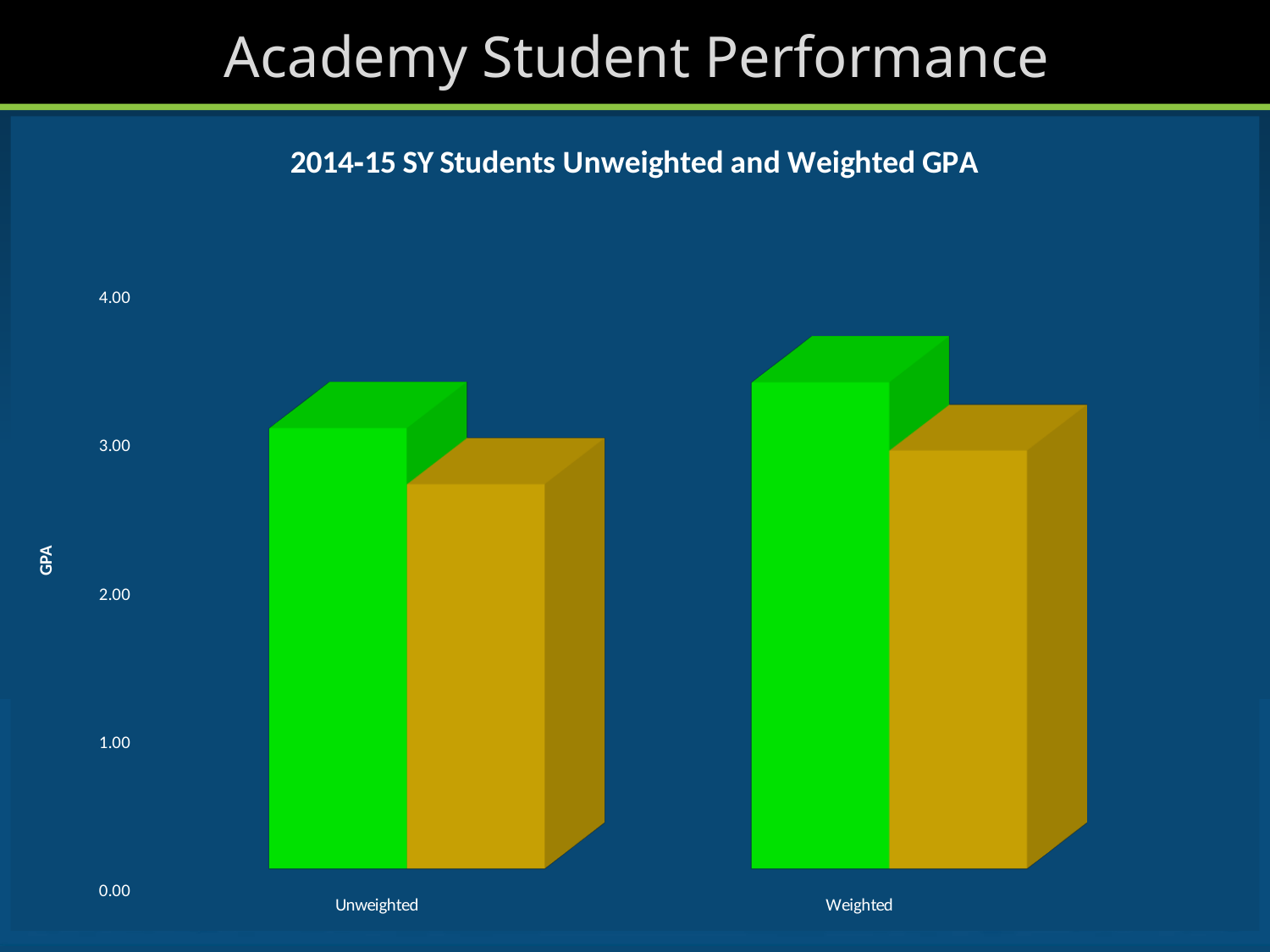
What is the label on the vertical axis of the chart? GPA Is the value of the green bar for Weighted greater or less than 4.00? less Which bar in the chart is the shortest? The gold bar for Unweighted Is the value of the gold bar for Unweighted greater or less than 3.00? less Is the value of the green bar for Unweighted greater or less than 2.00? greater In the Unweighted category, which bar is taller, the green bar or the gold bar? The green bar For the green bars, which category has the higher value, Unweighted or Weighted? Weighted What is the title of the chart? 2014-15 SY Students Unweighted and Weighted GPA What kind of chart is shown on the slide? Bar chart Which bar in the chart is the tallest? The green bar for Weighted How many categories are shown on the x axis of the chart? 2